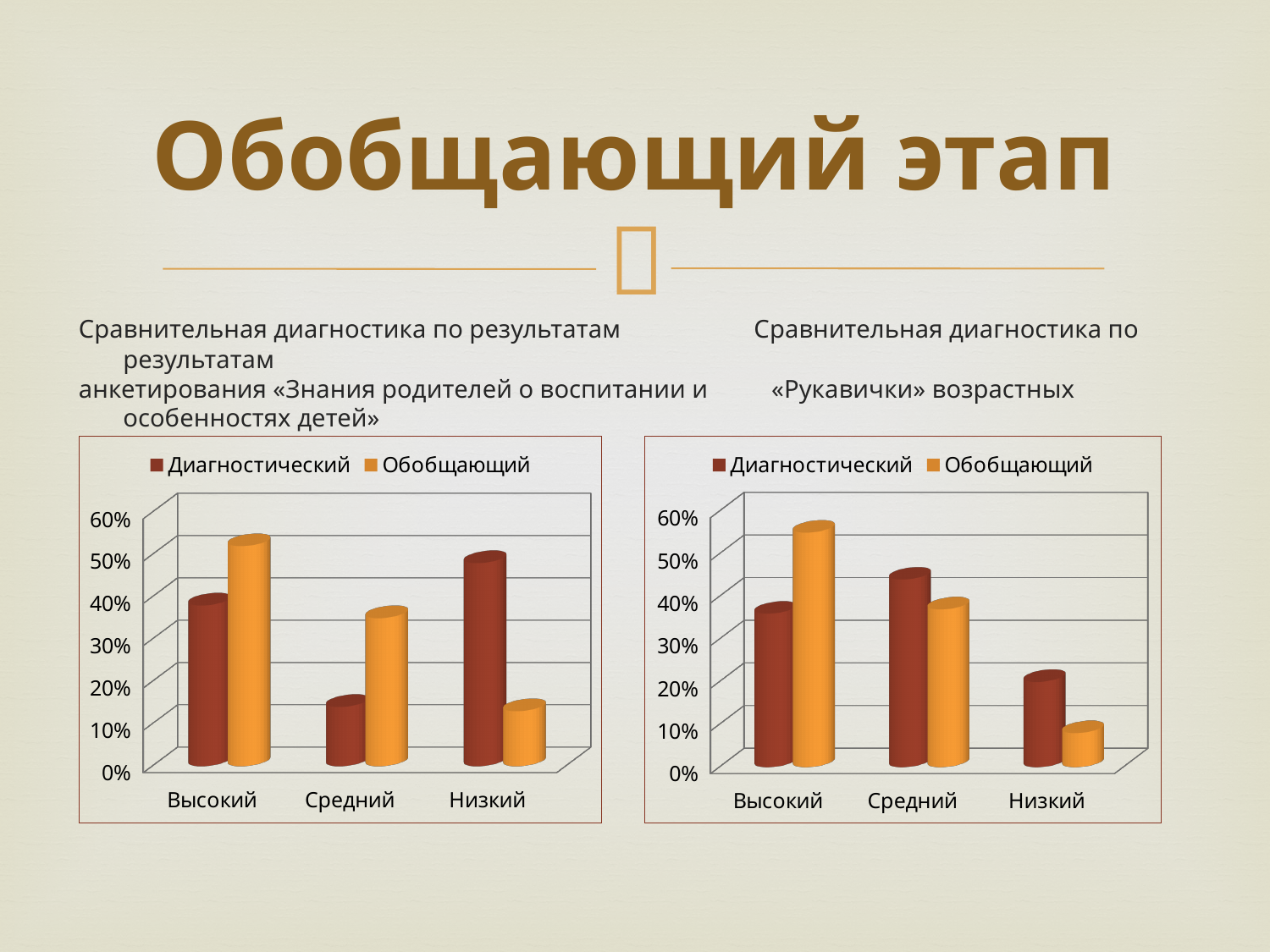
In the left chart, is the Обобщающий value for Высокий greater or less than 50%? greater In the right chart, which category has the highest Диагностический value? Средний In the left chart, is the Диагностический value for Средний greater or less than 20%? less In the left chart, which category has the highest Диагностический value? Низкий In the right chart, is the Обобщающий value for Низкий greater or less than 10%? less What kind of chart is the left chart on the slide? bar chart How many categories are shown on the x axis of the left chart? 3 In the right chart, do the Обобщающий values rise or fall from Высокий to Низкий? fall In the left chart, which category has the lowest Обобщающий value? Низкий In the right chart, which is larger for Высокий: the Диагностический value or the Обобщающий value? Обобщающий How many series does the legend of the right chart list? 2